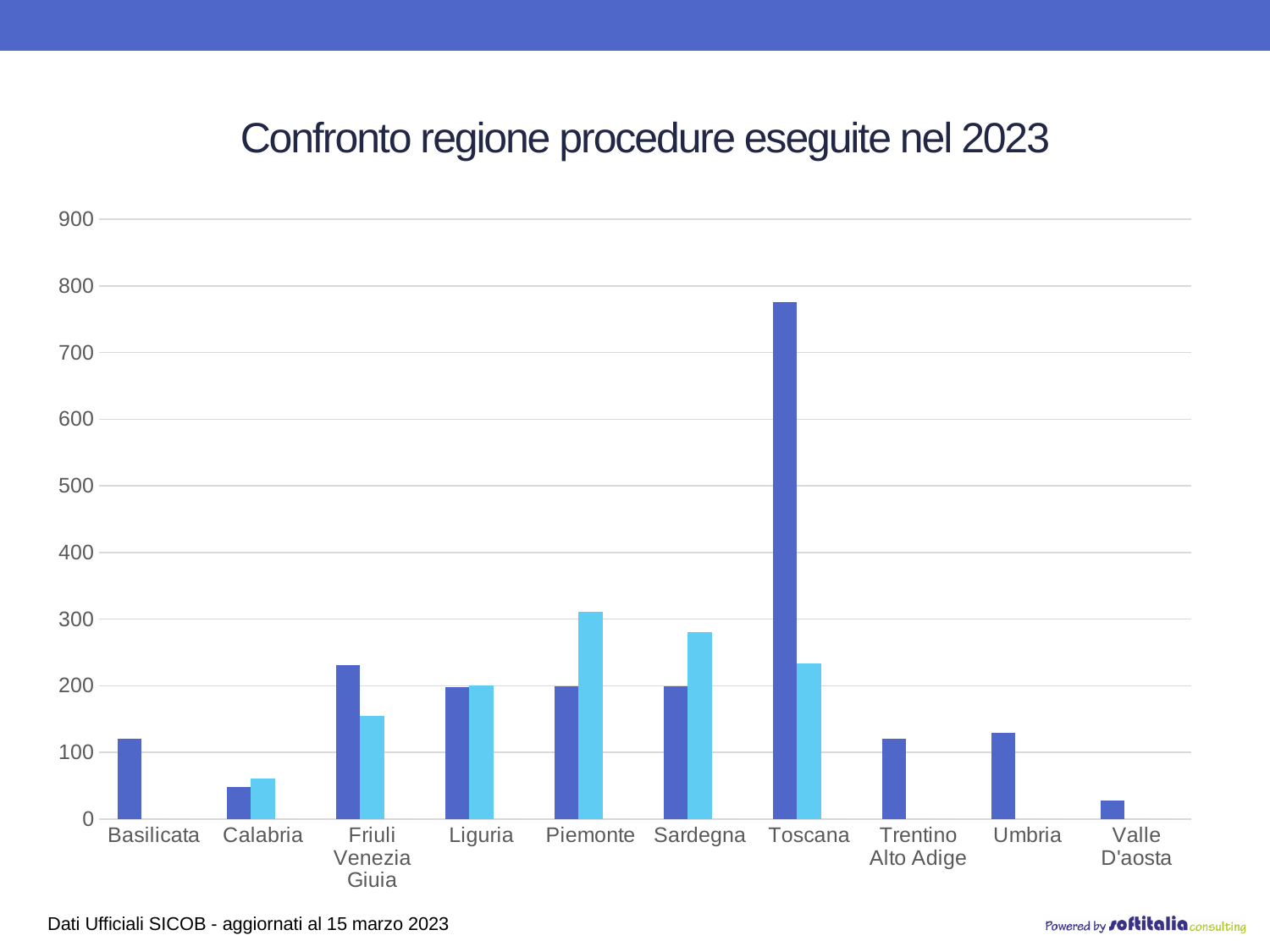
What kind of chart is shown on the slide? bar chart What is the title of the chart? Confronto regione procedure eseguite nel 2023 Which region has the tallest bar in the chart? Toscana Is the dark blue bar for Toscana greater or less than 700? greater Is the dark blue bar for Friuli Venezia Giuia greater or less than 200? greater Is the dark blue bar for Calabria greater or less than 100? less For Toscana, which bar is taller, the dark blue bar or the light blue bar? the dark blue bar For Piemonte, which bar is taller, the dark blue bar or the light blue bar? the light blue bar Which region has the shortest bar in the chart? Valle D'aosta How many regions are shown on the x axis of the chart? 10